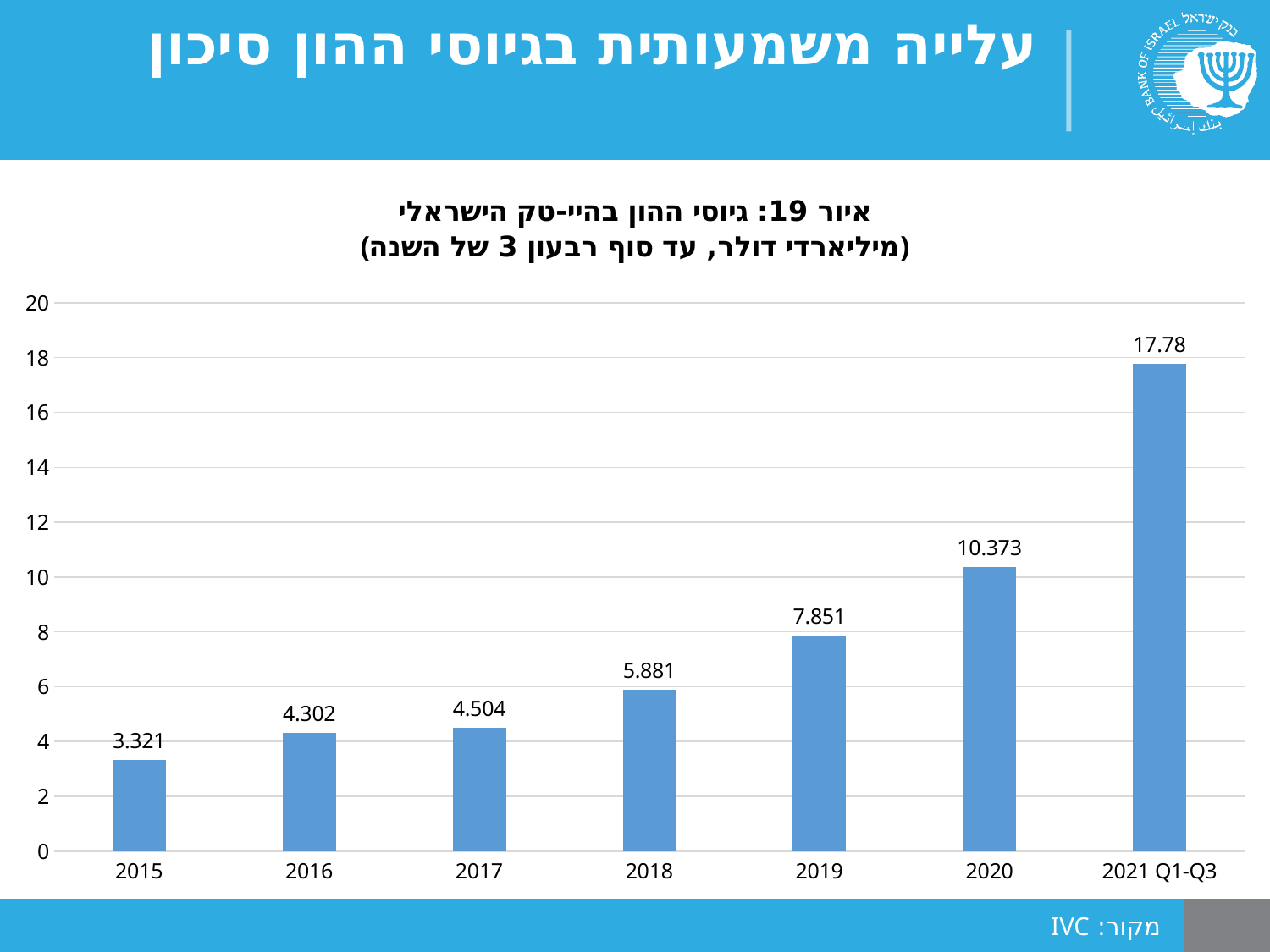
Do the values rise or fall from 2015 to 2021 Q1-Q3? rise What source is cited at the bottom of the slide? IVC How many categories are shown on the x axis? 7 What is the value for 2021 Q1-Q3? 17.78 Which category has the highest value? 2021 Q1-Q3 What is the difference between the values for 2020 and 2019? 2.522 What kind of chart is this? bar chart Which is larger, the value for 2016 or the value for 2017? 2017 What is the value for 2015? 3.321 Is the value for 2020 greater or less than 10? greater Which category has the lowest value? 2015 What is the value for 2018? 5.881